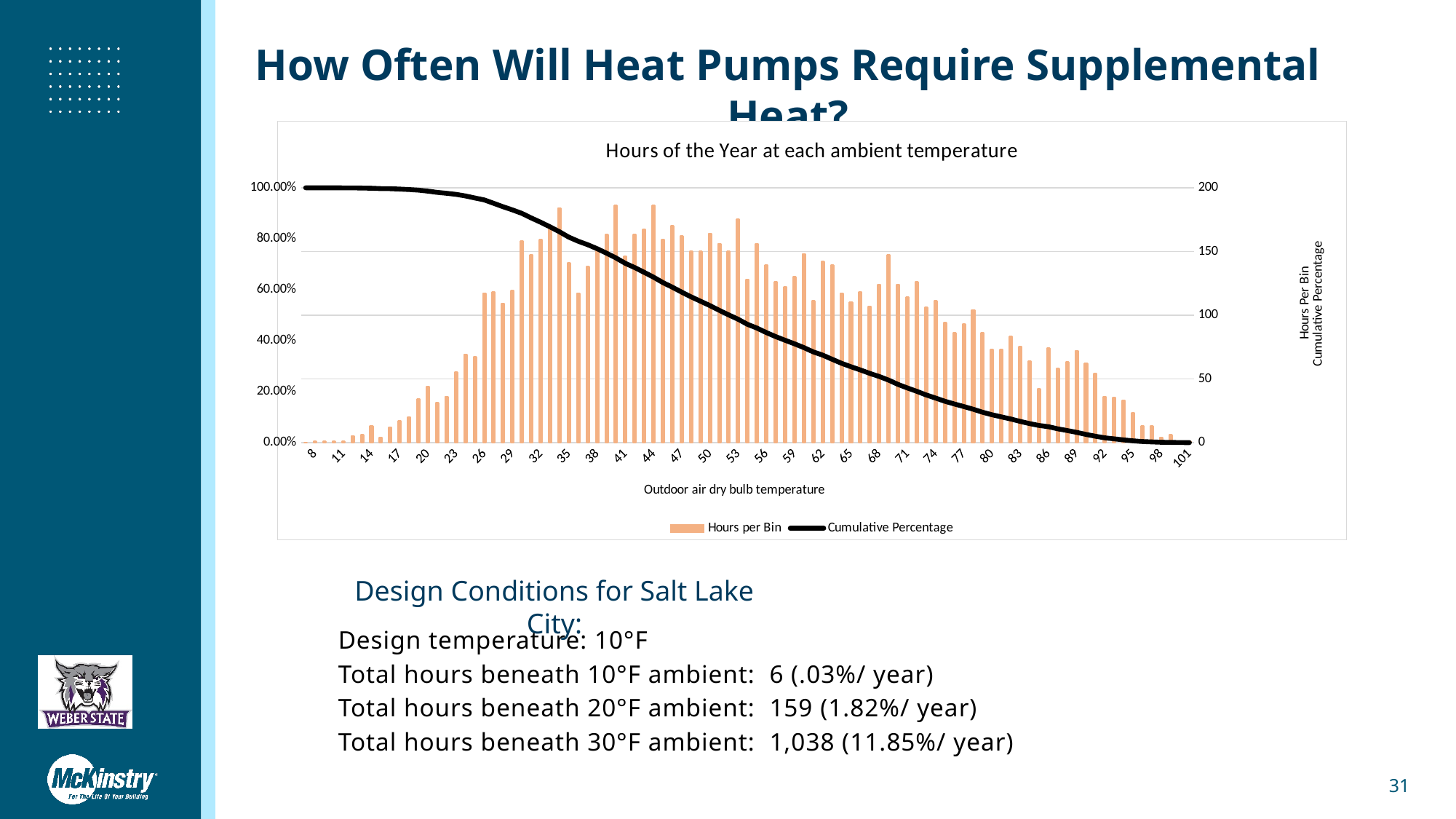
Is the Cumulative Percentage value at 35 greater or less than 60.00%? greater Which has more Hours per Bin, the bar at 29 or the bar at 89? 29 Is the Cumulative Percentage value at 71 greater or less than 40.00%? less What are the two series named in the chart legend? Hours per Bin and Cumulative Percentage Is the Hours per Bin value at 101 greater or less than 50? less Which has more Hours per Bin, the bar at 41 or the bar at 8? 41 Does the Cumulative Percentage line rise or fall as the outdoor air dry bulb temperature increases along the x axis? Fall How many series does the chart legend list? 2 What is the title of the chart? Hours of the Year at each ambient temperature What kind of chart is shown on the slide? Bar chart with a line